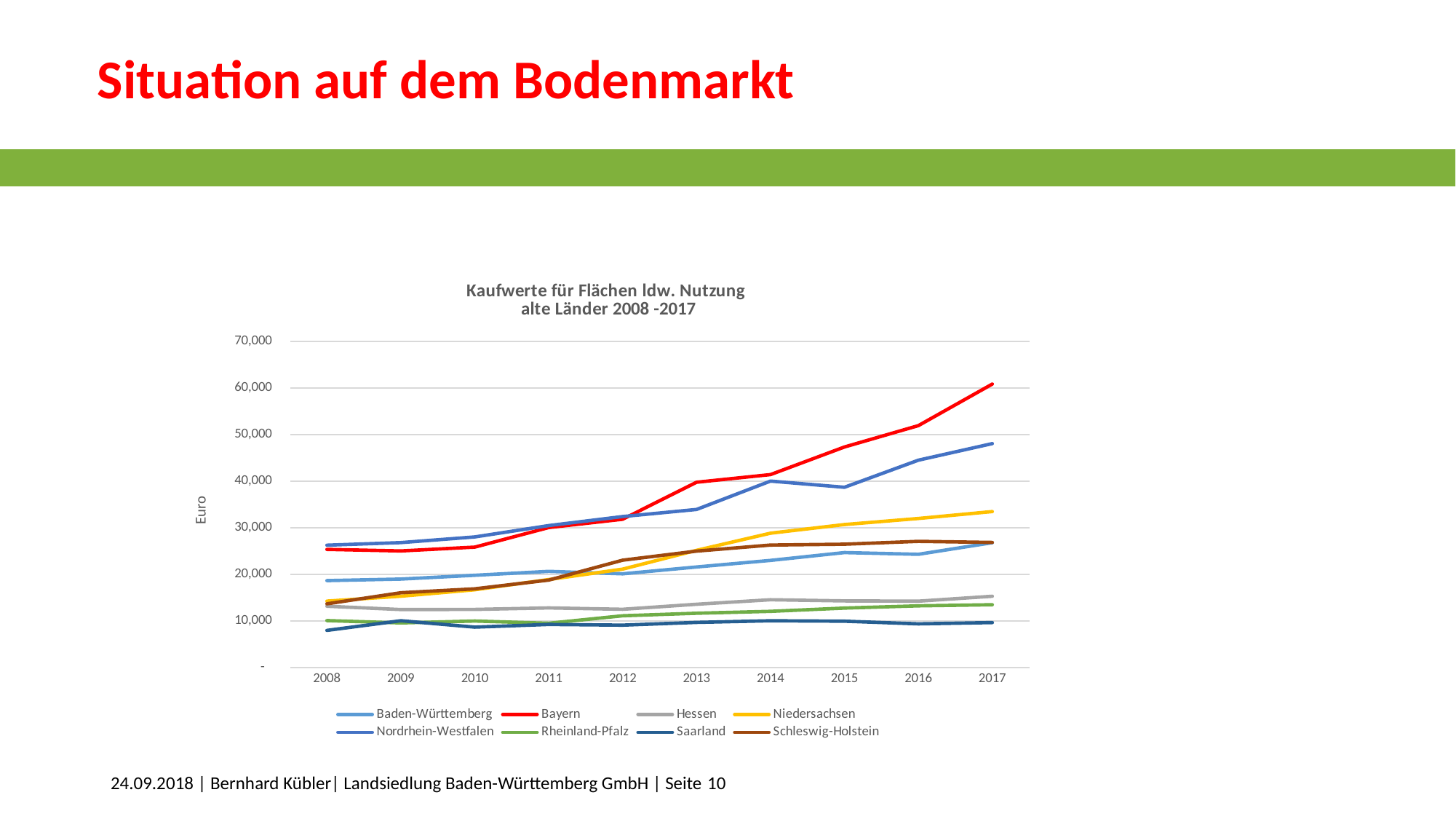
Which series has the lowest value in 2017? Saarland Is the value for Niedersachsen in 2017 greater or less than 30,000? greater Is the value for Bayern in 2017 greater or less than 50,000? greater Is the value for Nordrhein-Westfalen in 2017 greater or less than 40,000? greater Which series has the highest value in 2017? Bayern Does the value for Bayern rise or fall from 2008 to 2017? rise How many series does the legend list? 8 What kind of chart is shown on the slide? line chart What is the label on the y axis of the chart? Euro In 2008, which is larger: the value for Hessen or the value for Rheinland-Pfalz? Hessen How many years are shown on the x axis? 10